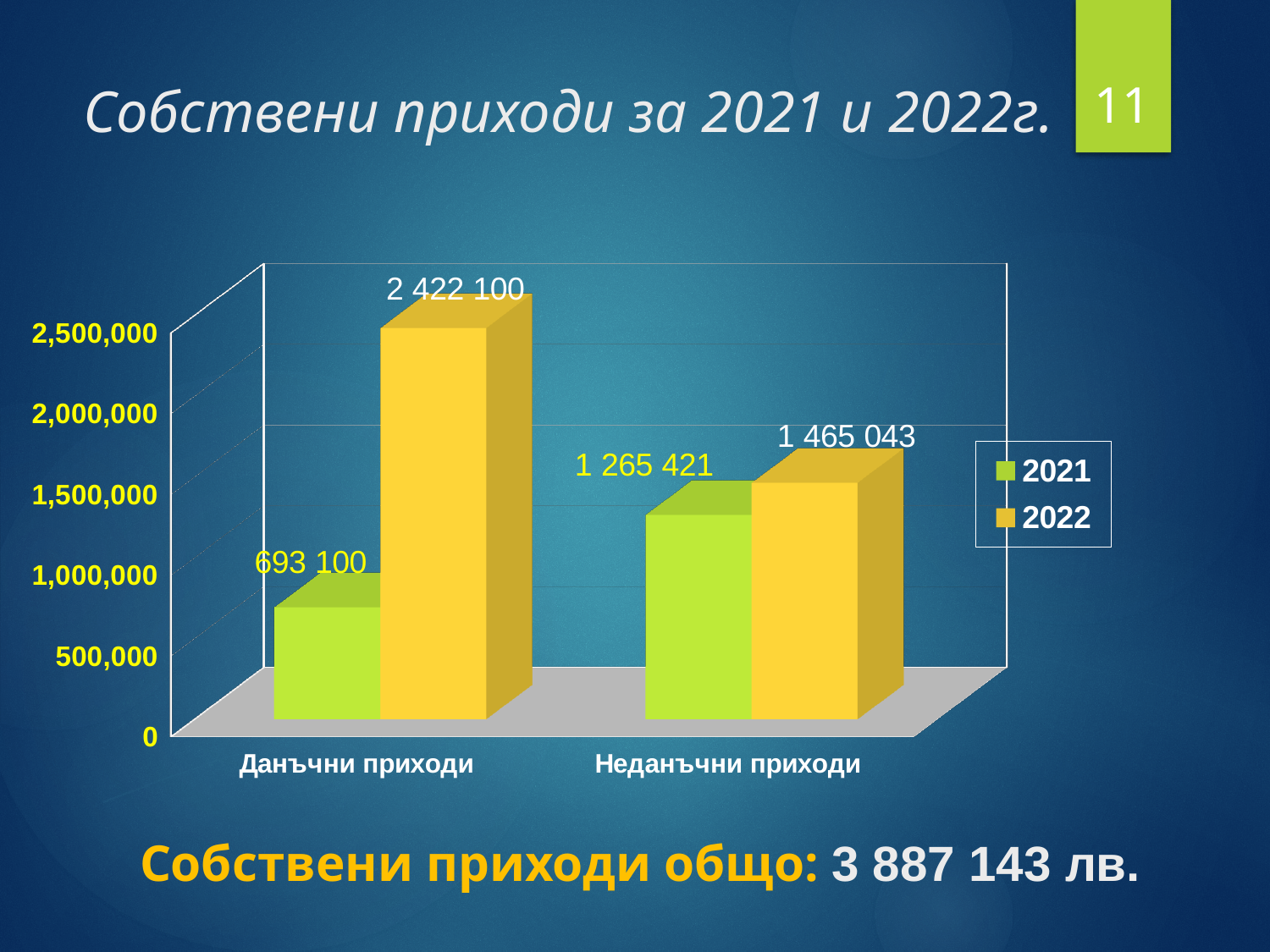
What is the difference between the 2022 and 2021 values for Неданъчни приходи? 199 622 Which bar has the lowest value on the chart? Данъчни приходи, 2021 Which colour represents the 2022 series in the legend? Yellow Which bar has the highest value on the chart? Данъчни приходи, 2022 What is the value for Неданъчни приходи in 2021? 1 265 421 What kind of chart is shown on the slide? Bar chart What is the value for Данъчни приходи in 2022? 2 422 100 What is the difference between the 2022 and 2021 values for Данъчни приходи? 1 729 000 How many series does the legend list? 2 What is the value for Данъчни приходи in 2021? 693 100 Which is larger: Неданъчни приходи in 2021 or Неданъчни приходи in 2022? Неданъчни приходи in 2022 What is the value for Неданъчни приходи in 2022? 1 465 043